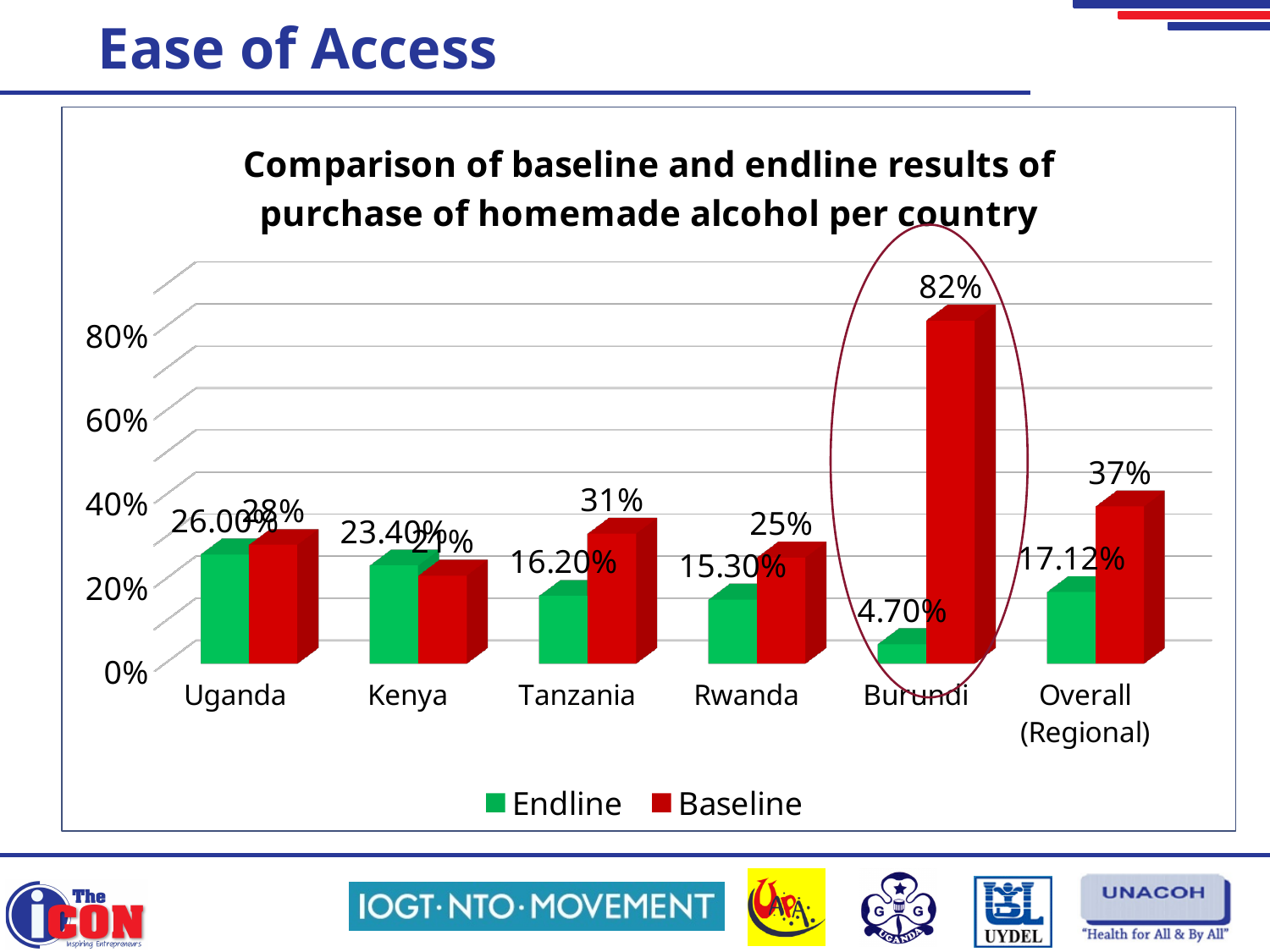
What is the Endline value for Overall (Regional)? 17.12% What is the Baseline value for Tanzania? 31% Which country has the highest Baseline value? Burundi What kind of chart is shown on the slide? Bar chart What is the Endline value for Rwanda? 15.30% What is the Baseline value for Burundi? 82% Which has the larger Baseline value, Tanzania or Rwanda? Tanzania How many categories are shown on the x axis? 6 How many series does the legend list? 2 What is the Endline value for Burundi? 4.70% What is the difference between the Baseline and Endline values for Burundi? 77.30 percentage points Which category has the lowest Endline value? Burundi